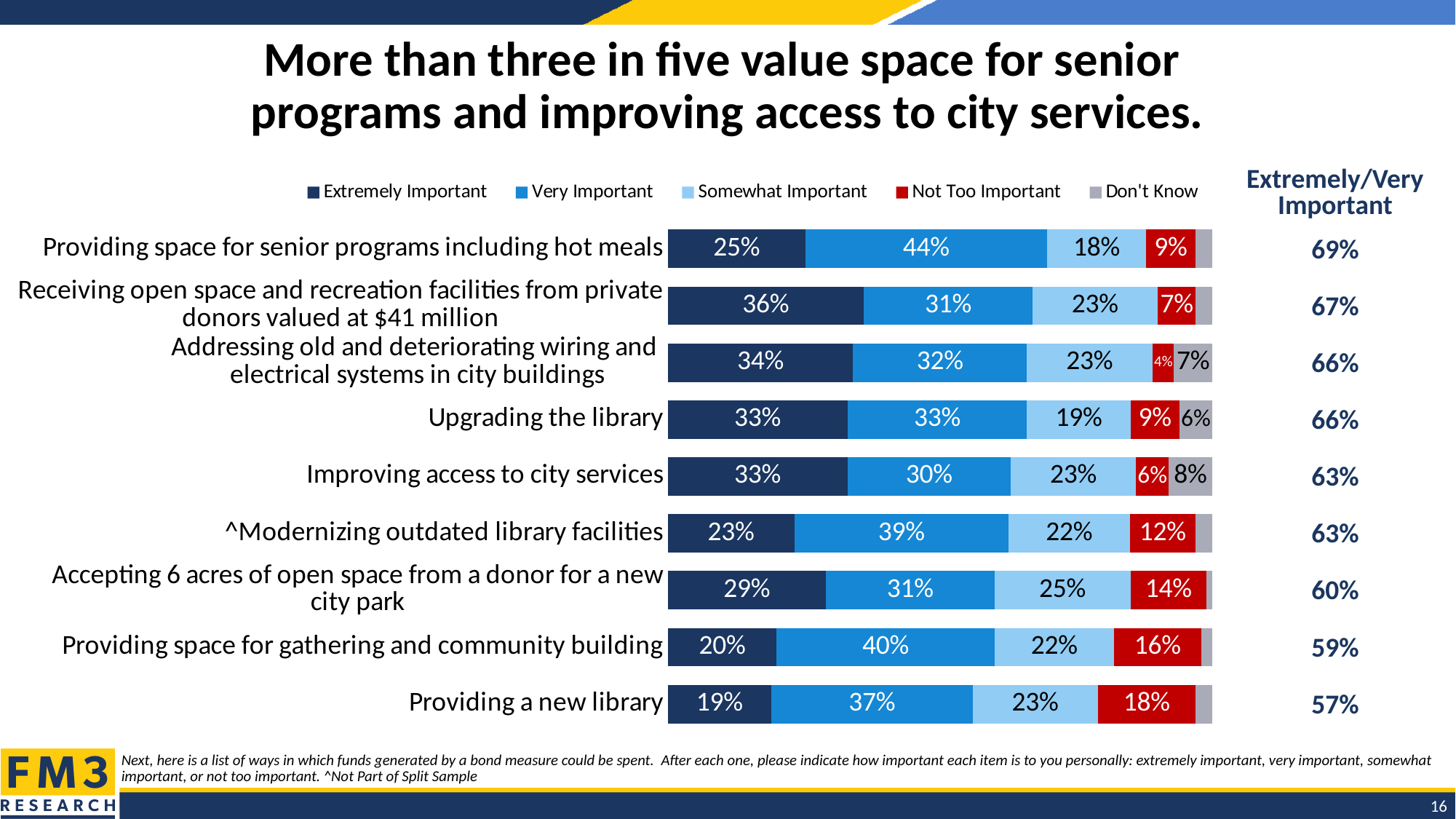
What kind of chart is shown on the slide? Stacked bar chart Which has a larger Very Important value: "Providing space for gathering and community building" or "Accepting 6 acres of open space from a donor for a new city park"? Providing space for gathering and community building What is the Very Important value for "Providing space for senior programs including hot meals"? 44% How many items are listed in the chart? 9 What is the Don't Know value for "Improving access to city services"? 8% What is the combined Extremely/Very Important total for "Addressing old and deteriorating wiring and electrical systems in city buildings"? 66% What is the Not Too Important value for "Providing a new library"? 18% How many series does the legend list? 5 Which item has the highest Extremely Important percentage? Receiving open space and recreation facilities from private donors valued at $41 million What is the difference between the Not Too Important values for "Providing a new library" and "Providing space for senior programs including hot meals"? 9% Which item has the lowest Extremely Important percentage? Providing a new library What percentage of respondents rated "Upgrading the library" as Extremely Important? 33%